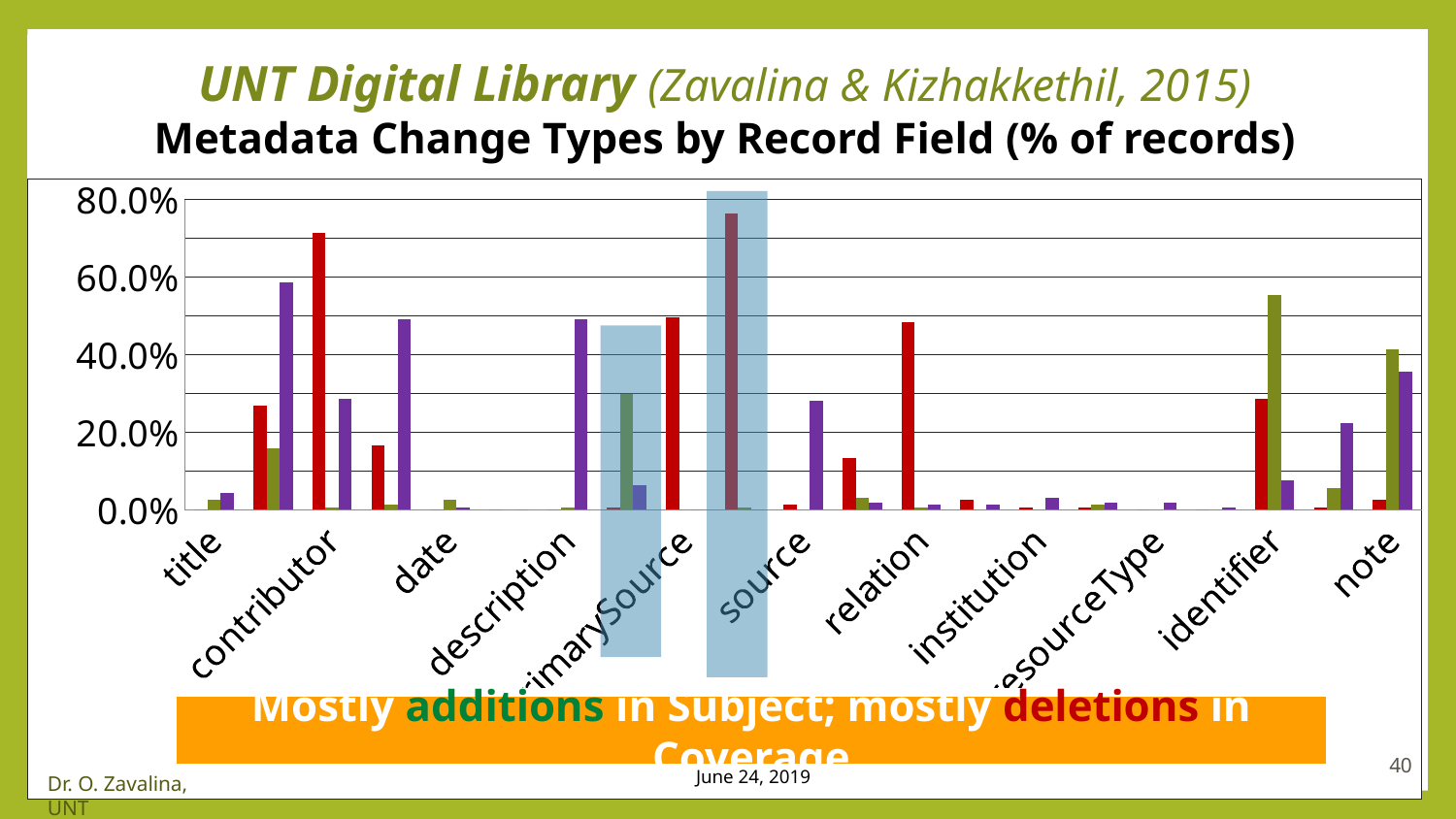
What kind of chart is shown on the slide? bar chart Is the tallest bar on the chart greater or less than 60%? greater Is the tallest bar on the chart greater or less than 80%? less How many differently coloured bar series are plotted on the chart? 3 What is the highest value shown on the chart's y axis? 80.0% What is the title of the chart on the slide? Metadata Change Types by Record Field (% of records) Is the tallest bar for the title field greater or less than 20%? less